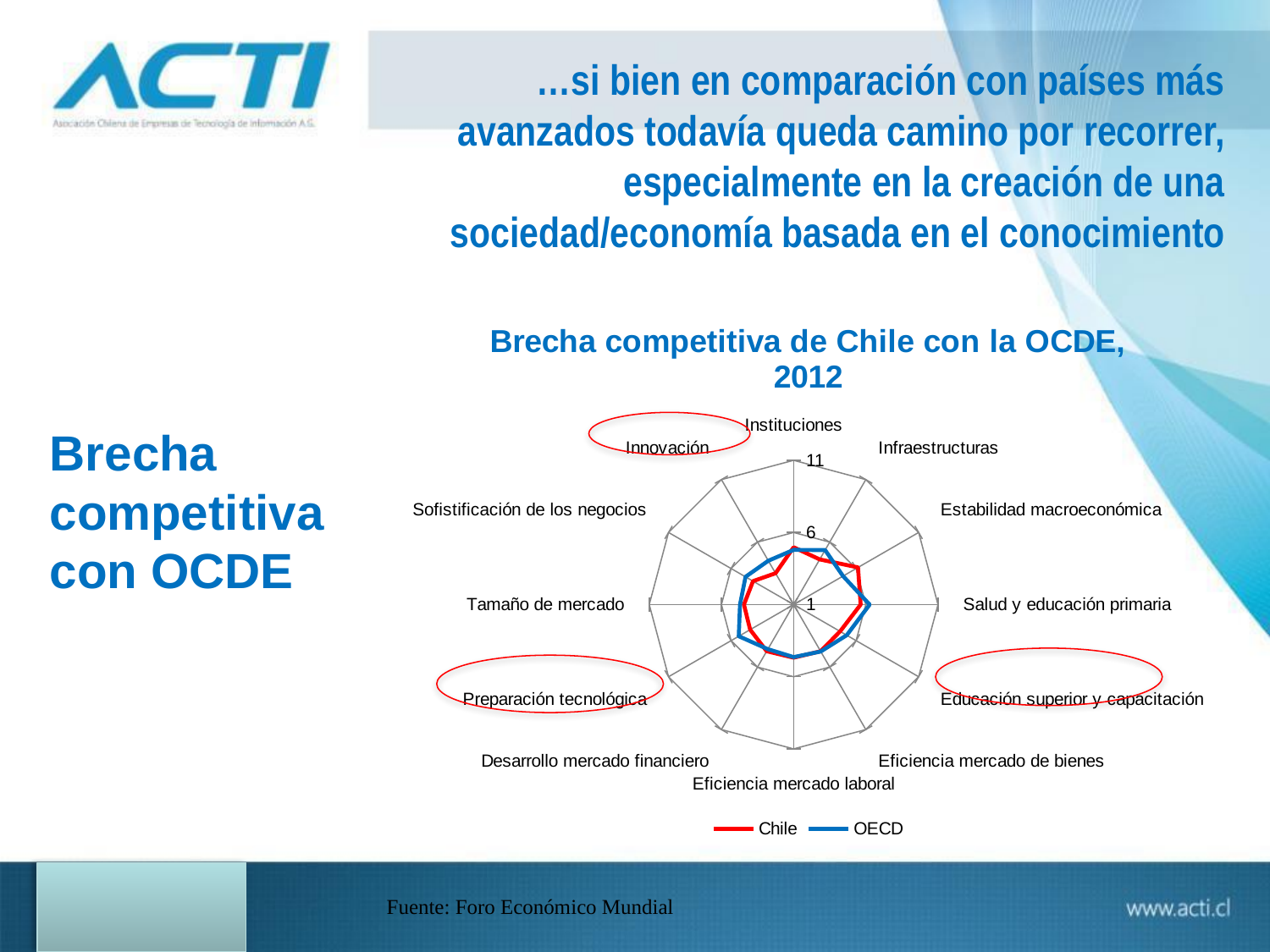
How many categories (axes) does the radar chart have? 12 For Preparación tecnológica, which series has the larger value, Chile or OECD? OECD Is the Chile value for Instituciones greater or less than 6? less How many series does the legend of the chart list? 2 What kind of chart is shown on the slide? Radar chart Is the OECD value for Innovación greater or less than 6? less What is the title of the chart? Brecha competitiva de Chile con la OCDE, 2012 Is the OECD value for Salud y educación primaria greater or less than 11? less For Innovación, which series has the larger value, Chile or OECD? OECD Which series is drawn in blue in the chart? OECD For Educación superior y capacitación, which series has the larger value, Chile or OECD? OECD